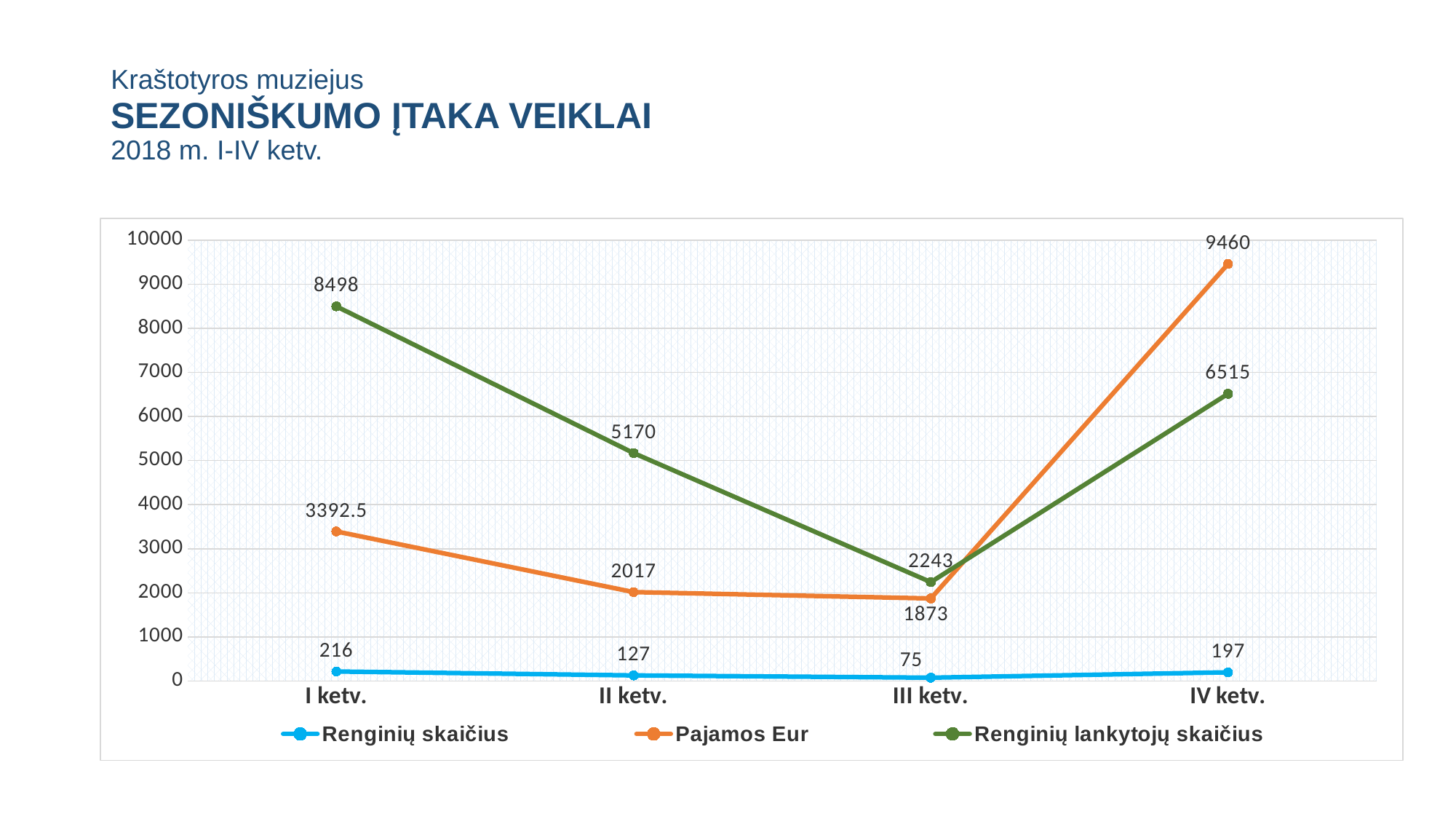
Does Renginių lankytojų skaičius rise or fall from I ketv. to III ketv.? fall What is the value of Pajamos Eur in I ketv.? 3392.5 What is the difference between Renginių lankytojų skaičius in I ketv. and II ketv.? 3328 How many quarters (categories) are plotted on the x axis? 4 In which quarter is Renginių lankytojų skaičius lowest? III ketv. Which is larger in IV ketv.: Pajamos Eur or Renginių lankytojų skaičius? Pajamos Eur What is the value of Pajamos Eur in IV ketv.? 9460 In which quarter is Pajamos Eur highest? IV ketv. What is the value of Renginių lankytojų skaičius in I ketv.? 8498 What kind of chart is shown on the slide? line chart How many series does the legend list? 3 What is the value of Renginių skaičius in III ketv.? 75